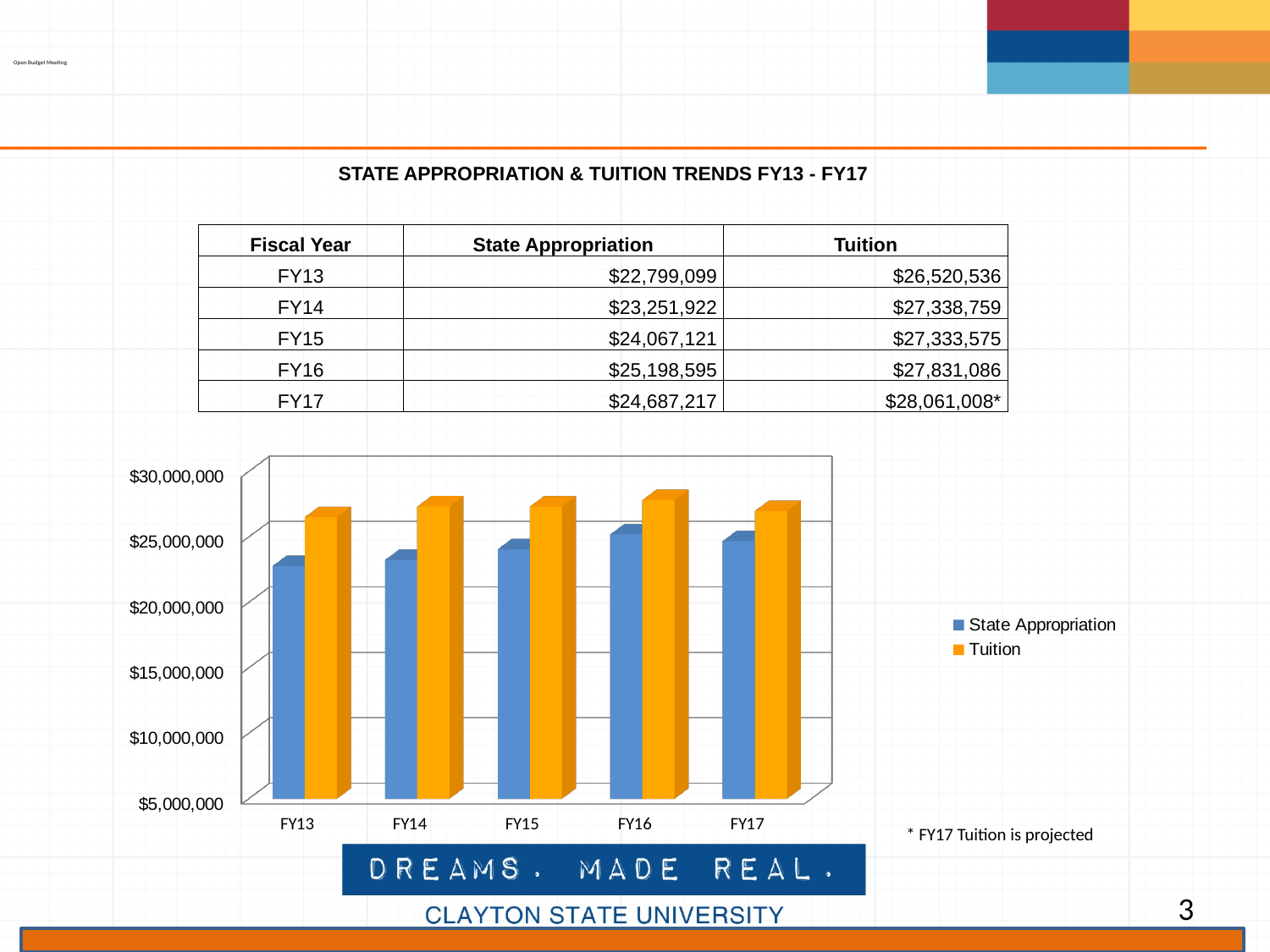
What type of chart is shown on the slide? bar chart Is the State Appropriation value for FY13 greater or less than $25,000,000? less How many series does the chart legend list? 2 What is the State Appropriation value for FY13? $22,799,099 Which series is shown in orange in the chart? Tuition How many fiscal years are plotted on the x axis of the chart? 5 Which fiscal year has the highest State Appropriation? FY16 Which is larger in FY17, State Appropriation or Tuition? Tuition Does Tuition rise or fall from FY13 to FY17? rises What is the difference between Tuition and State Appropriation in FY13? $3,721,437 Which fiscal year has the lowest Tuition? FY13 What is the Tuition value for FY16? $27,831,086